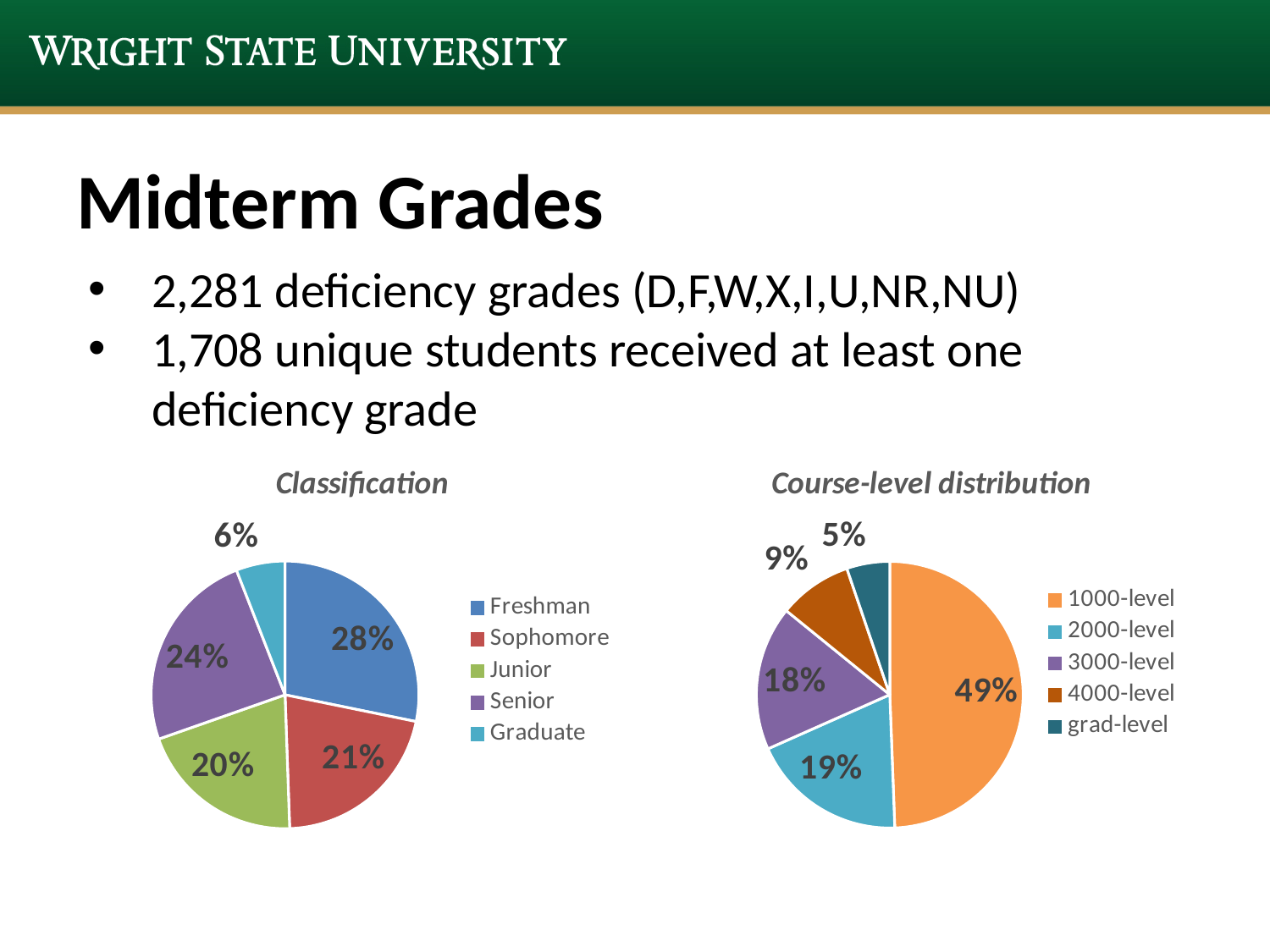
In the Classification chart, what share of the pie is Freshman? 28% What type of chart is the Course-level distribution chart? Pie chart In the Course-level distribution chart, which is larger, 2000-level or 3000-level? 2000-level In the Course-level distribution chart, what is the difference between the 1000-level and 2000-level percentages? 30% In the Classification chart, how many categories does the legend list? 5 In the Course-level distribution chart, which category has the smallest slice? grad-level In the Course-level distribution chart, what percentage is shown for 4000-level? 9% In the Classification chart, what percentage is shown for Senior? 24% In the Classification chart, which category has the smallest slice? Graduate In the Classification chart, which category has the largest slice? Freshman In the Course-level distribution chart, what share of the pie is 1000-level? 49% In the Classification chart, what is the difference between the Senior and Junior percentages? 4%